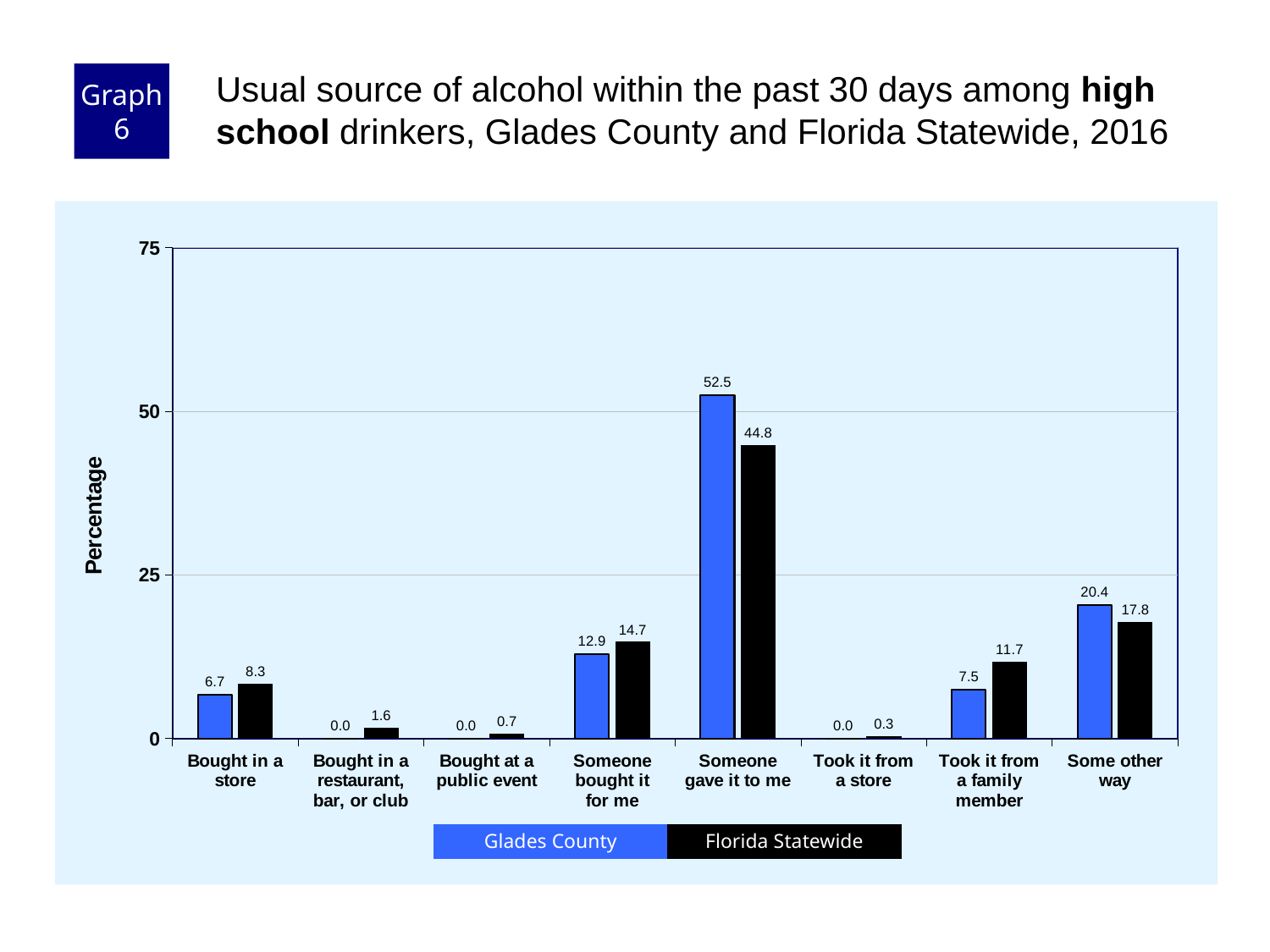
How many categories are shown on the x axis? 8 What is the Glades County value for "Some other way"? 20.4 How many series does the legend list? 2 What is the difference between the Florida Statewide and Glades County values for "Took it from a family member"? 4.2 What is the Florida Statewide value for "Took it from a family member"? 11.7 Which is larger for "Bought in a store": Glades County or Florida Statewide? Florida Statewide What is the Glades County value for "Someone gave it to me"? 52.5 Which category has the lowest Florida Statewide value? Took it from a store What is the difference between the Glades County and Florida Statewide values for "Someone gave it to me"? 7.7 Is the Glades County value for "Someone gave it to me" greater or less than 50? greater What kind of chart is shown on the slide? bar chart Which category has the highest Florida Statewide value? Someone gave it to me